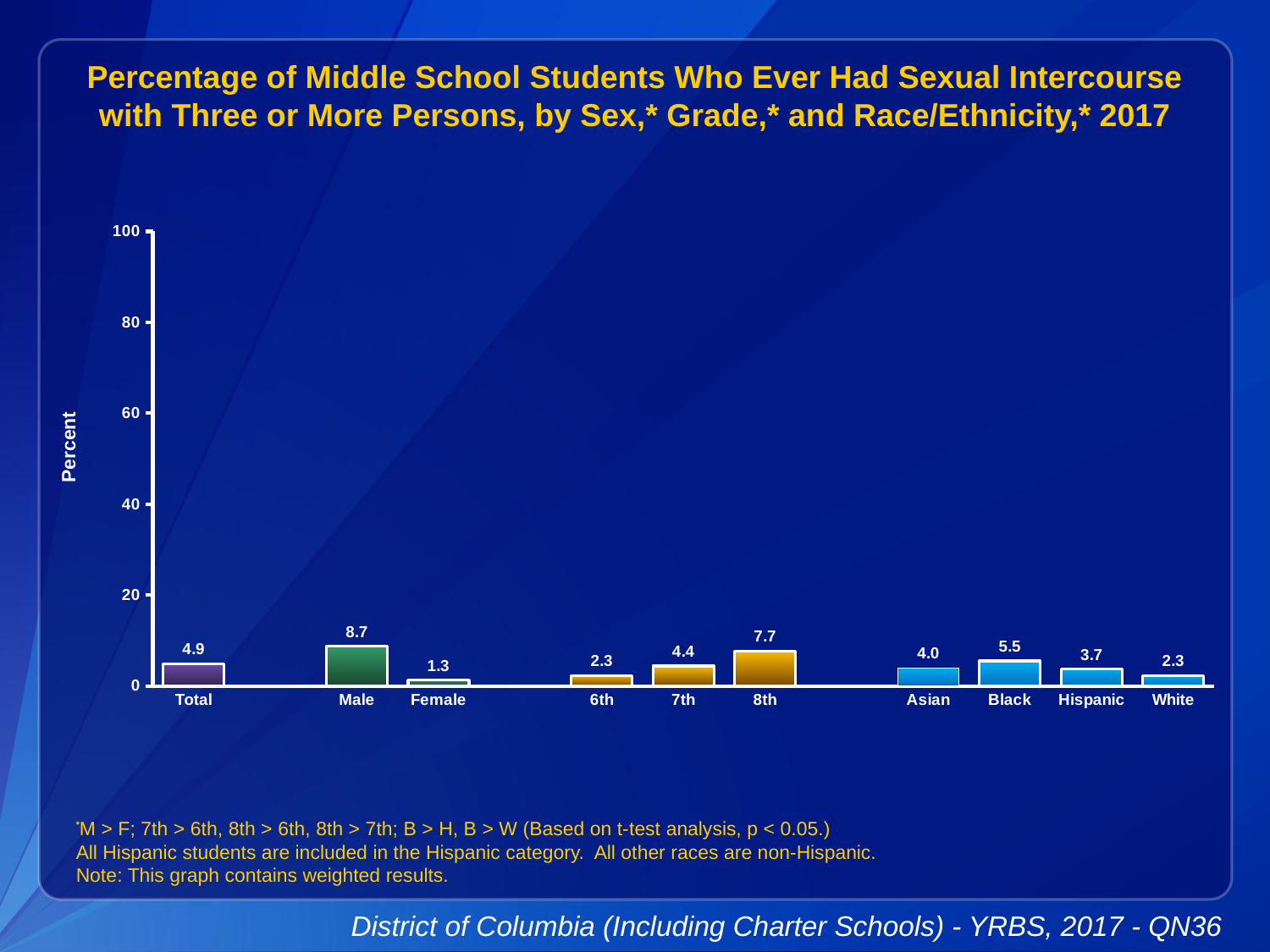
Which category has the highest value? Male What is the value for Male? 8.7 Which is larger, the value for Black or the value for Asian? Black Which category has the lowest value? Female What is the difference between the values for Male and Female? 7.4 What is the difference between the values for 8th and 6th grade? 5.4 What kind of chart is shown on the slide? bar chart What is the value for Female? 1.3 How many categories are shown on the x axis? 10 Is the value for Total greater or less than 20? less What is the value for 8th grade? 7.7 What is the value for Hispanic? 3.7